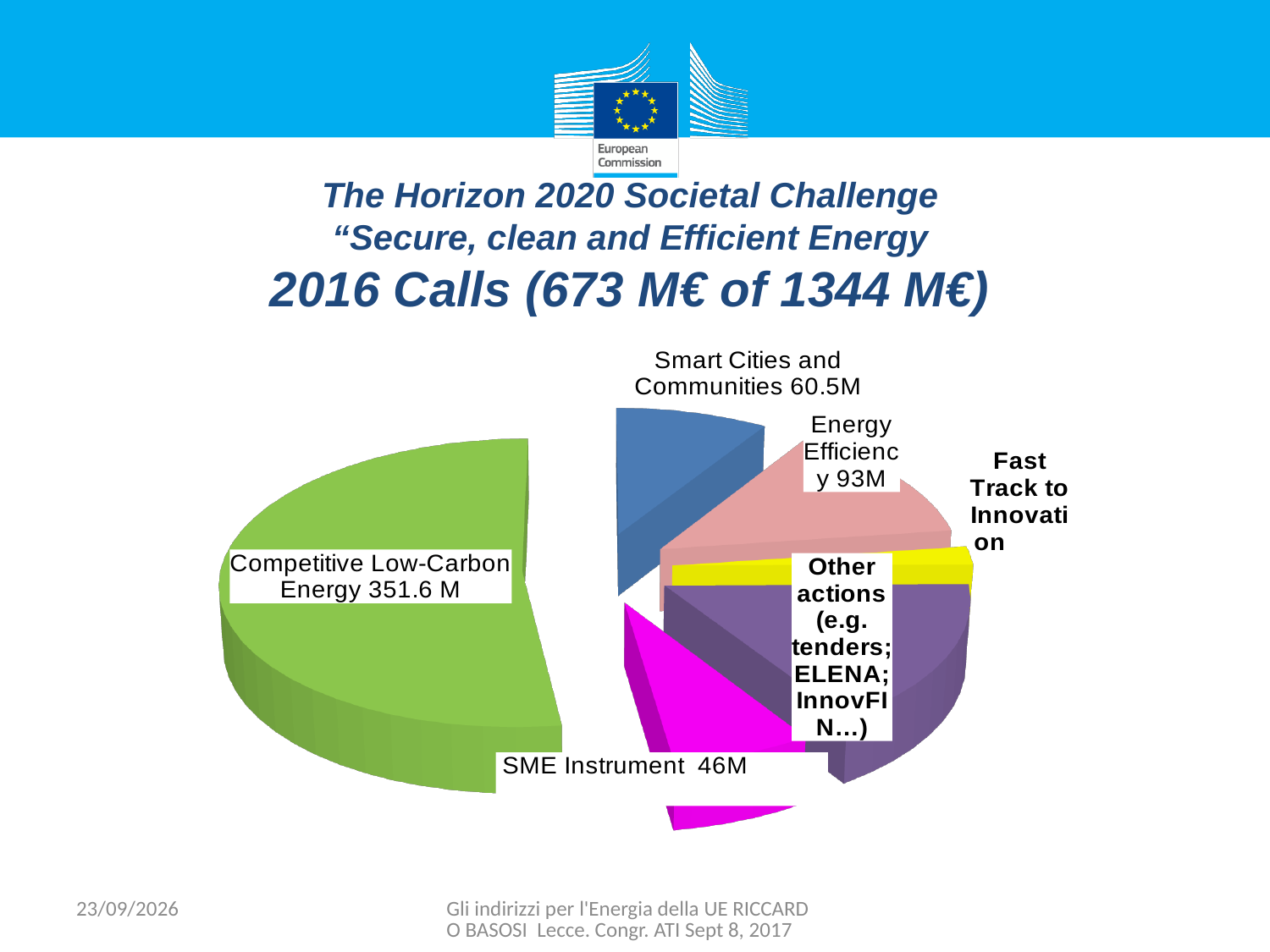
What is the value shown for Energy Efficiency? 93M What is the difference between the Competitive Low-Carbon Energy value and the SME Instrument value? 305.6 M How many slices does the pie chart have? 6 What kind of chart is shown on the slide? Pie chart What is the value shown for Smart Cities and Communities? 60.5M What is the difference between the Energy Efficiency value and the Smart Cities and Communities value? 32.5M What colour is the Competitive Low-Carbon Energy slice? Green Which slice of the pie chart is the largest? Competitive Low-Carbon Energy Which is larger, Energy Efficiency or Smart Cities and Communities? Energy Efficiency What is the value shown for SME Instrument? 46M Which slice of the pie chart is the smallest? Fast Track to Innovation What is the value shown for Competitive Low-Carbon Energy? 351.6 M